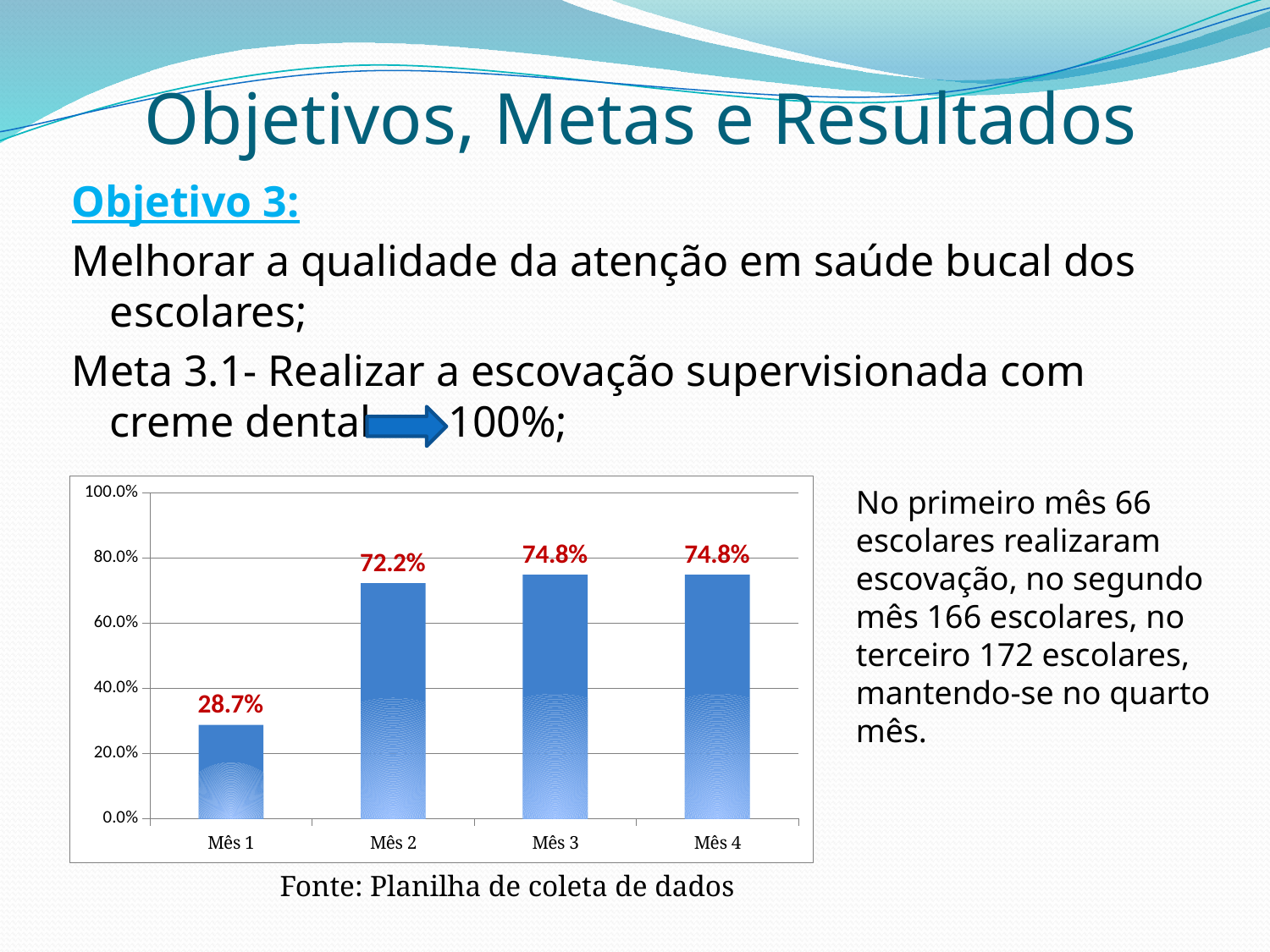
Do the values rise or fall from Mês 1 to Mês 3? rise What is the value for Mês 1? 28.7% Which is larger, the value for Mês 1 or the value for Mês 2? Mês 2 What is the value for Mês 4? 74.8% Is the value for Mês 3 greater or less than 80.0%? less How many months are shown on the x axis? 4 What is the difference between the values for Mês 3 and Mês 2? 2.6% Which month has the lowest value? Mês 1 What is the value for Mês 3? 74.8% What kind of chart is shown on the slide? bar chart What is the value for Mês 2? 72.2% What is the difference between the values for Mês 2 and Mês 1? 43.5%